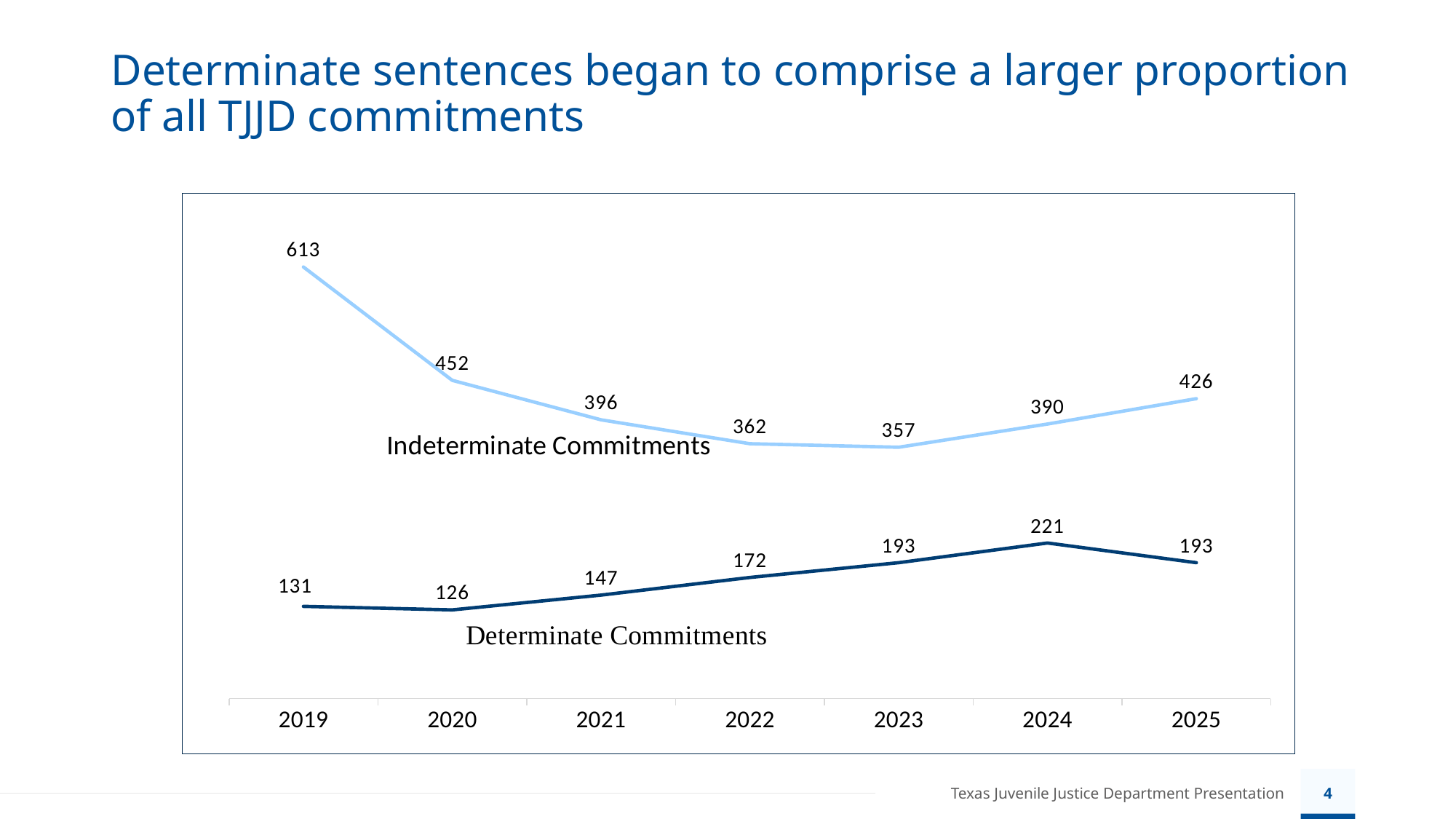
Did Determinate Commitments rise or fall from 2020 to 2024? Rise What was the value of Indeterminate Commitments in 2019? 613 What kind of chart is shown on the slide? Line chart In which year were Determinate Commitments lowest? 2020 In which year were Indeterminate Commitments lowest? 2023 How many years are shown on the x axis? 7 What is the difference between Indeterminate and Determinate Commitments in 2025? 233 What was the value of Determinate Commitments in 2024? 221 What was the value of Indeterminate Commitments in 2023? 357 What is the difference between Indeterminate Commitments in 2019 and 2020? 161 In which year were Determinate Commitments highest? 2024 Which was larger in 2022: Indeterminate Commitments or Determinate Commitments? Indeterminate Commitments